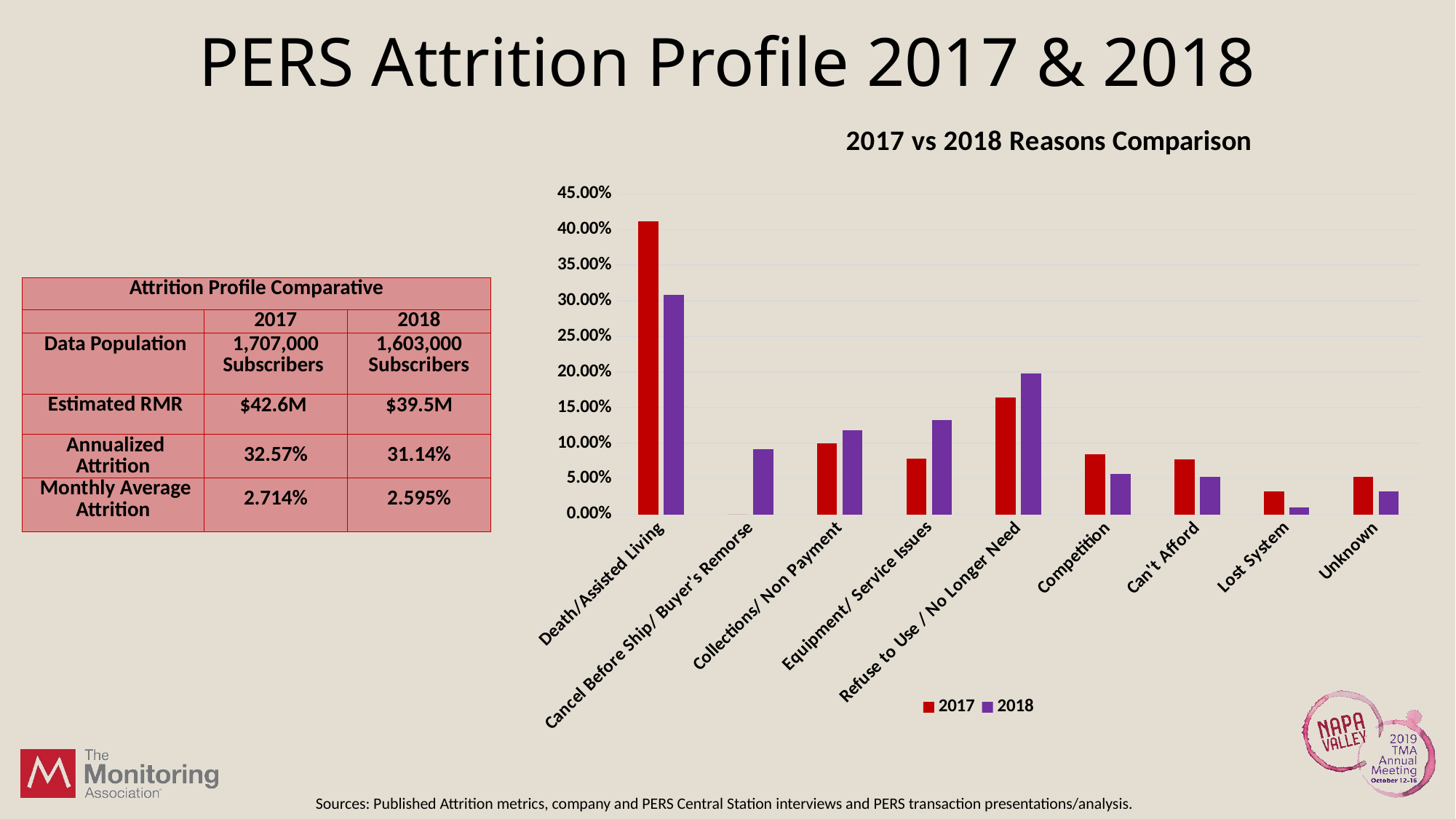
Which category has the highest 2017 value in the chart? Death/Assisted Living Which category has the lowest 2018 value in the chart? Lost System What kind of chart is shown on the slide? Bar chart Is the 2018 value for Refuse to Use / No Longer Need greater or less than 15.00%? greater Is the 2018 value for Lost System greater or less than 5.00%? less For Refuse to Use / No Longer Need, which year has the larger value, 2017 or 2018? 2018 How many series does the legend of the '2017 vs 2018 Reasons Comparison' chart list? 2 Which category has the highest 2018 value in the chart? Death/Assisted Living For Death/Assisted Living, which year has the larger value, 2017 or 2018? 2017 What colour represents the 2018 series in the chart? Purple Is the 2017 value for Death/Assisted Living greater or less than 35.00%? greater How many attrition reason categories are shown on the x axis of the chart? 9